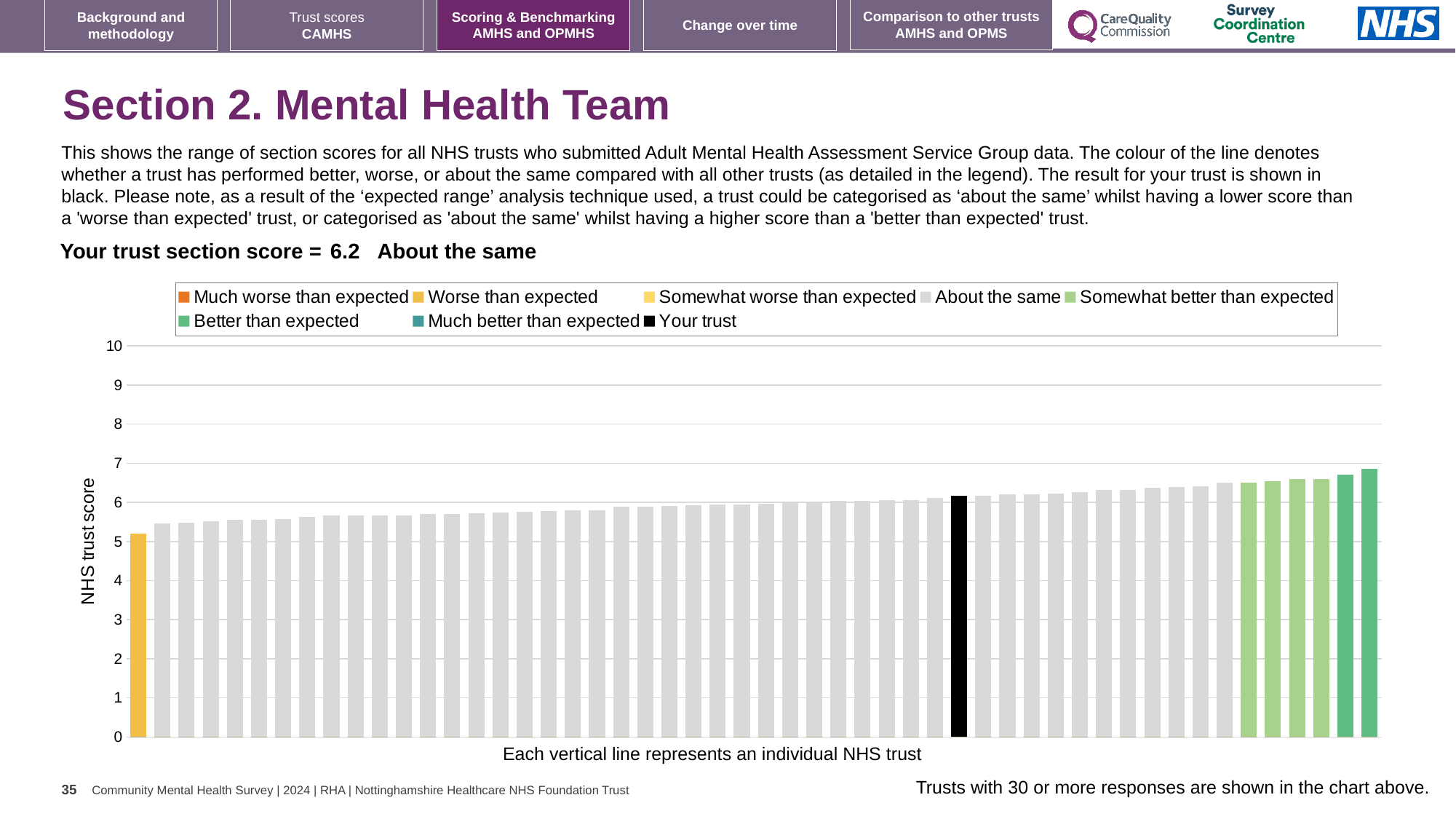
Is the value of the tallest bar on the right greater or less than 7? less What kind of chart is shown on the slide? bar chart What is the label on the vertical axis of the chart? NHS trust score Which legend category does the tallest bar belong to? Better than expected Do the bar values rise or fall from left to right along the x axis? rise What category is your trust placed in according to the text above the chart? About the same How many bars are coloured as 'Worse than expected' (yellow)? 1 Is the value of the leftmost (yellow) bar greater or less than 6? less What is your trust's section score for Mental Health Team? 6.2 Is the value for your trust (the black bar) greater or less than 6? greater How many entries does the chart legend list? 8 Which legend category does the shortest bar belong to? Worse than expected